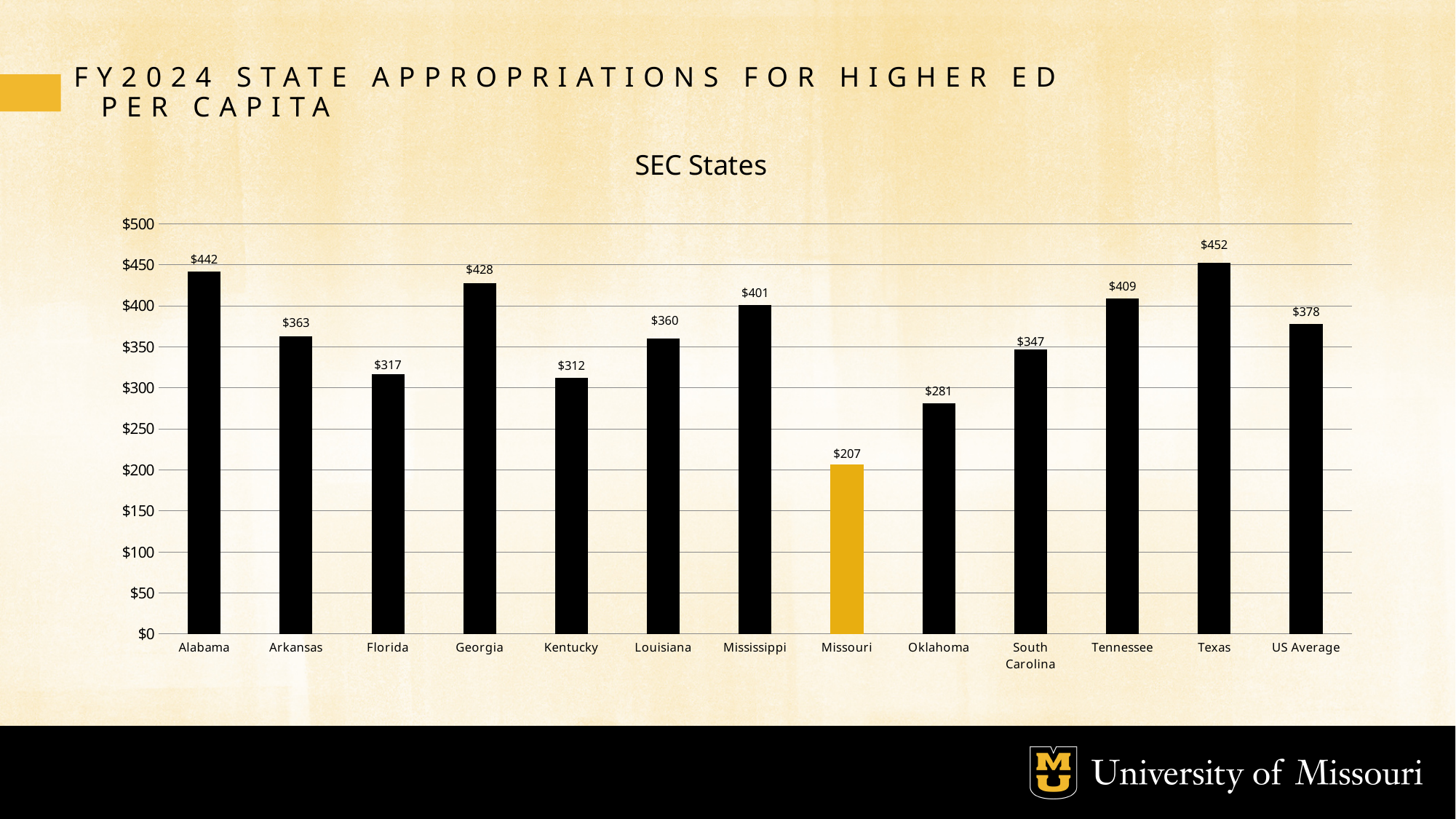
What is the value for Missouri? $207 What is the difference between the values for Alabama and Missouri? $235 What kind of chart is shown on the slide? bar chart What is the value for Texas? $452 Which category has the lowest value? Missouri Is the value for Oklahoma greater or less than $300? less What is the value for US Average? $378 How many categories are shown on the x axis? 13 Which bar is highlighted in a different colour (gold) from the others? Missouri Which is larger, the value for Georgia or the value for Mississippi? Georgia Which category has the highest value? Texas What is the difference between the values for US Average and Missouri? $171